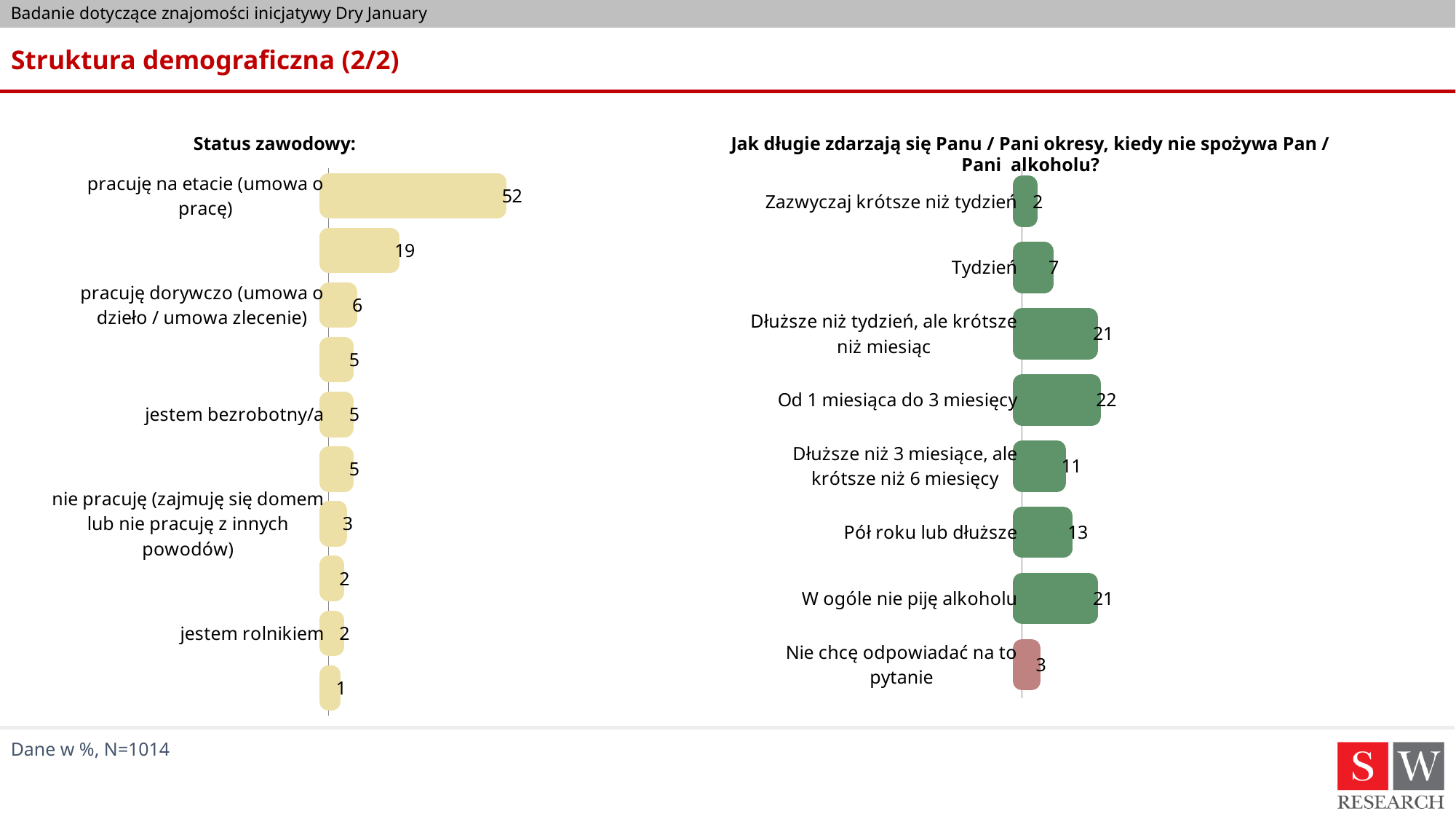
In the chart on the right about periods without drinking alcohol, which is larger: 'Tydzień' or 'Dłuższe niż 3 miesiące, ale krótsze niż 6 miesięcy'? Dłuższe niż 3 miesiące, ale krótsze niż 6 miesięcy In the 'Status zawodowy:' chart, what is the value for 'jestem bezrobotny/a'? 5 In the chart on the right about periods without drinking alcohol, what is the value for 'Od 1 miesiąca do 3 miesięcy'? 22 In the chart on the right about periods without drinking alcohol, how many categories are shown? 8 In the 'Status zawodowy:' chart, what is the difference between 'pracuję na etacie (umowa o pracę)' and 'pracuję dorywczo (umowa o dzieło / umowa zlecenie)'? 46 In the 'Status zawodowy:' chart, which category has the highest value? pracuję na etacie (umowa o pracę) What type of chart is the 'Status zawodowy:' chart? bar chart In the chart on the right about periods without drinking alcohol, what is the value for 'Pół roku lub dłuższe'? 13 In the 'Status zawodowy:' chart, how many bars are plotted? 10 In the chart on the right about periods without drinking alcohol, which category has the lowest value? Zazwyczaj krótsze niż tydzień In the 'Status zawodowy:' chart, what is the value for 'pracuję na etacie (umowa o pracę)'? 52 In the 'Status zawodowy:' chart, what is the value for 'jestem rolnikiem'? 2